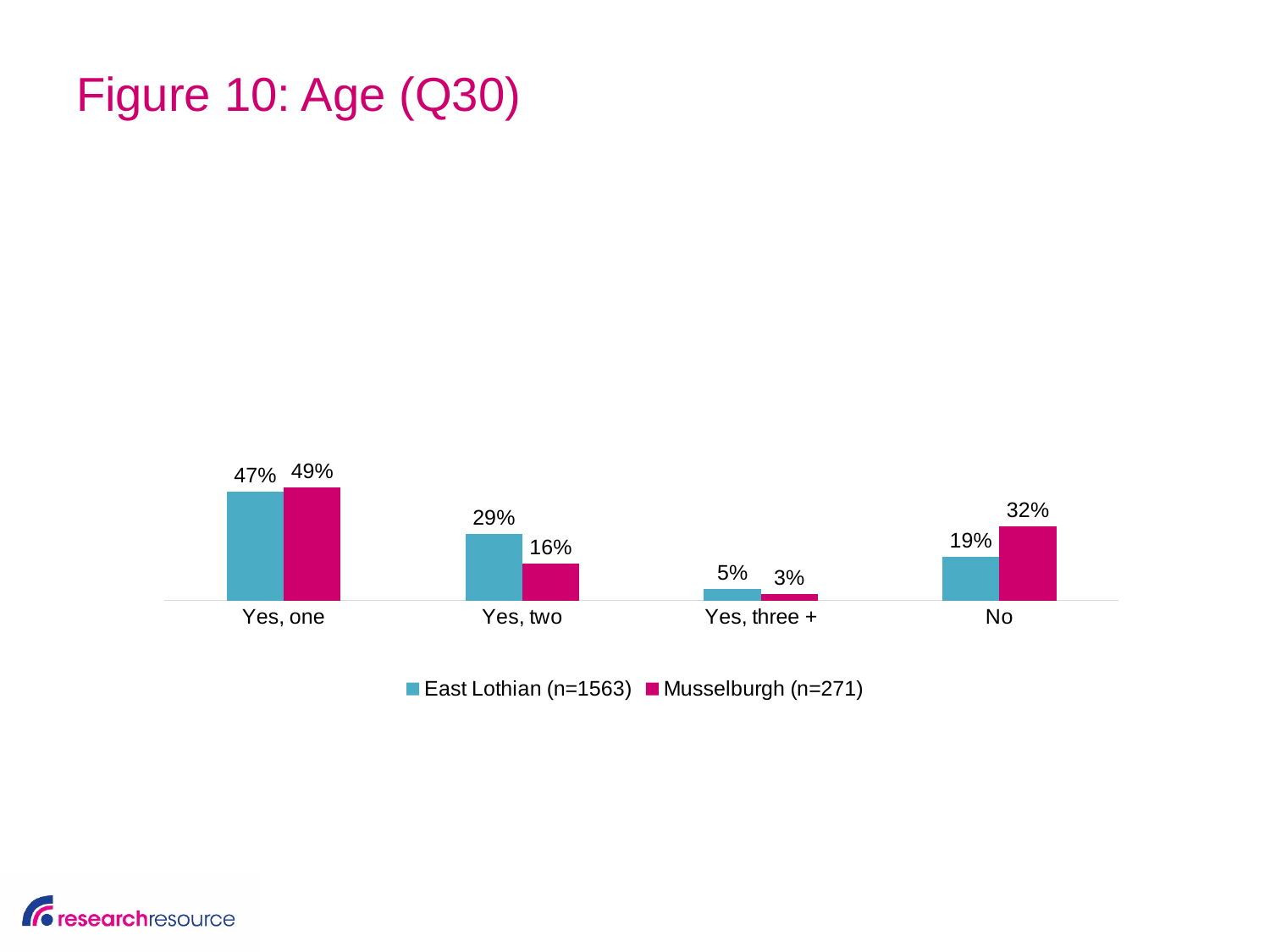
In the "Yes, three +" category, which series has the larger value, East Lothian (n=1563) or Musselburgh (n=271)? East Lothian (n=1563) How many series does the legend list? 2 Which category has the highest value for East Lothian (n=1563)? Yes, one What is the value for Musselburgh (n=271) in the "No" category? 32% What is the difference between East Lothian (n=1563) and Musselburgh (n=271) in the "Yes, two" category? 13% What is the value for Musselburgh (n=271) in the "Yes, two" category? 16% What is the title of the slide? Figure 10: Age (Q30) Which category has the lowest value for Musselburgh (n=271)? Yes, three + How many categories are shown on the x axis? 4 What kind of chart is shown on the slide? Bar chart What is the difference between Musselburgh (n=271) and East Lothian (n=1563) in the "No" category? 13% What is the value for East Lothian (n=1563) in the "Yes, one" category? 47%